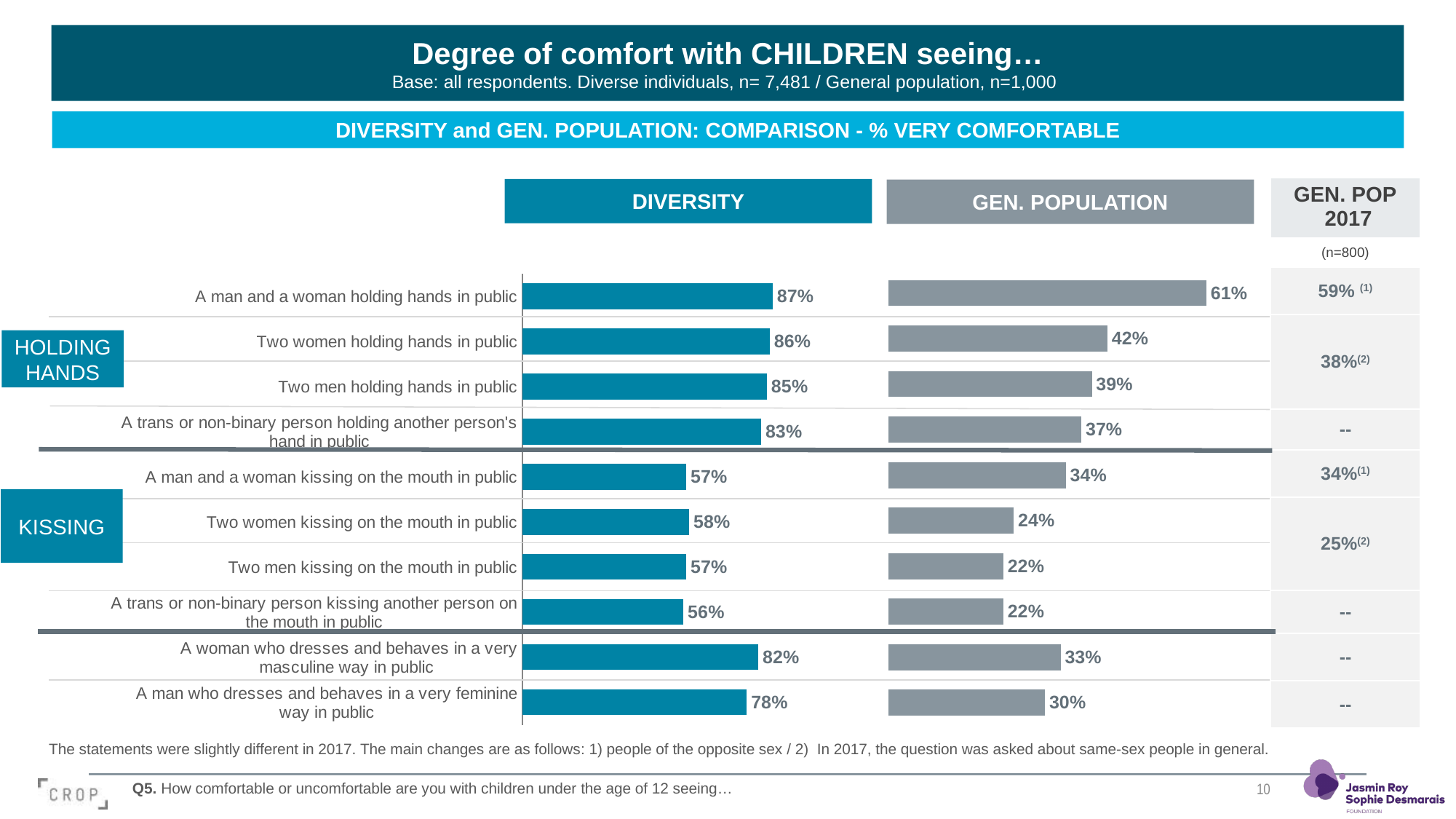
What kind of chart is the DIVERSITY chart? Bar chart What is the GEN. POP 2017 value shown for "A man and a woman kissing on the mouth in public"? 34% In the DIVERSITY chart, what is the value for "A man and a woman kissing on the mouth in public"? 57% What is the difference between the DIVERSITY and GEN. POPULATION values for "Two men holding hands in public"? 46 percentage points What is the title of the slide? Degree of comfort with CHILDREN seeing… How many categories are shown in the DIVERSITY chart? 10 In the DIVERSITY chart, what is the value for "Two women holding hands in public"? 86% In the DIVERSITY chart, which category has the lowest value? A trans or non-binary person kissing another person on the mouth in public In the GEN. POPULATION chart, what is the value for "A man who dresses and behaves in a very feminine way in public"? 30% In the GEN. POPULATION chart, what is the difference between "A man and a woman holding hands in public" and "Two women holding hands in public"? 19 percentage points In the GEN. POPULATION chart, which is larger: the value for "Two women kissing on the mouth in public" or "A woman who dresses and behaves in a very masculine way in public"? A woman who dresses and behaves in a very masculine way in public In the GEN. POPULATION chart, which category has the highest value? A man and a woman holding hands in public